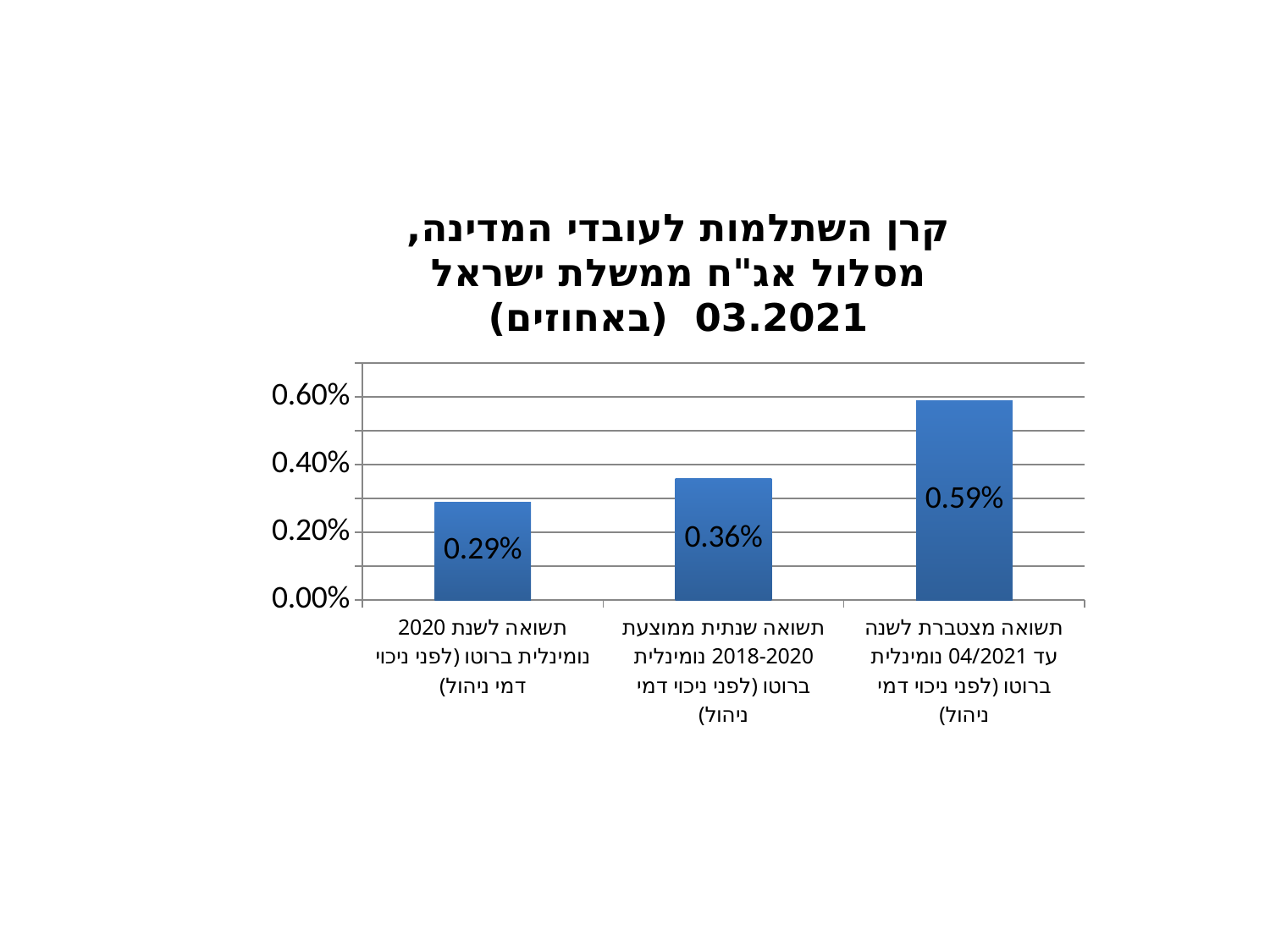
What is the difference between the average annual return 2018-2020 and the return for 2020? 0.07% What is the value for the category "תשואה לשנת 2020 נומינלית ברוטו (לפני ניכוי דמי ניהול)" (return for 2020)? 0.29% What type of chart is shown on the slide? bar chart Which category has the lowest value? תשואה לשנת 2020 נומינלית ברוטו (לפני ניכוי דמי ניהול) How many bars (categories) does the chart show? 3 What is the difference between the cumulative return to 04/2021 (0.59%) and the return for 2020 (0.29%)? 0.30% Is the value for the cumulative return to 04/2021 greater or less than 0.40%? greater Which is larger: the average annual return 2018-2020 or the return for 2020? the average annual return 2018-2020 (0.36%) What is the value for the category "תשואה מצטברת לשנה עד 04/2021 נומינלית ברוטו" (cumulative return for the year to 04/2021)? 0.59% What is the value for the category "תשואה שנתית ממוצעת 2018-2020 נומינלית ברוטו" (average annual return 2018-2020)? 0.36% What is the highest tick label shown on the vertical axis? 0.60% Which category has the highest value? תשואה מצטברת לשנה עד 04/2021 נומינלית ברוטו (לפני ניכוי דמי ניהול)